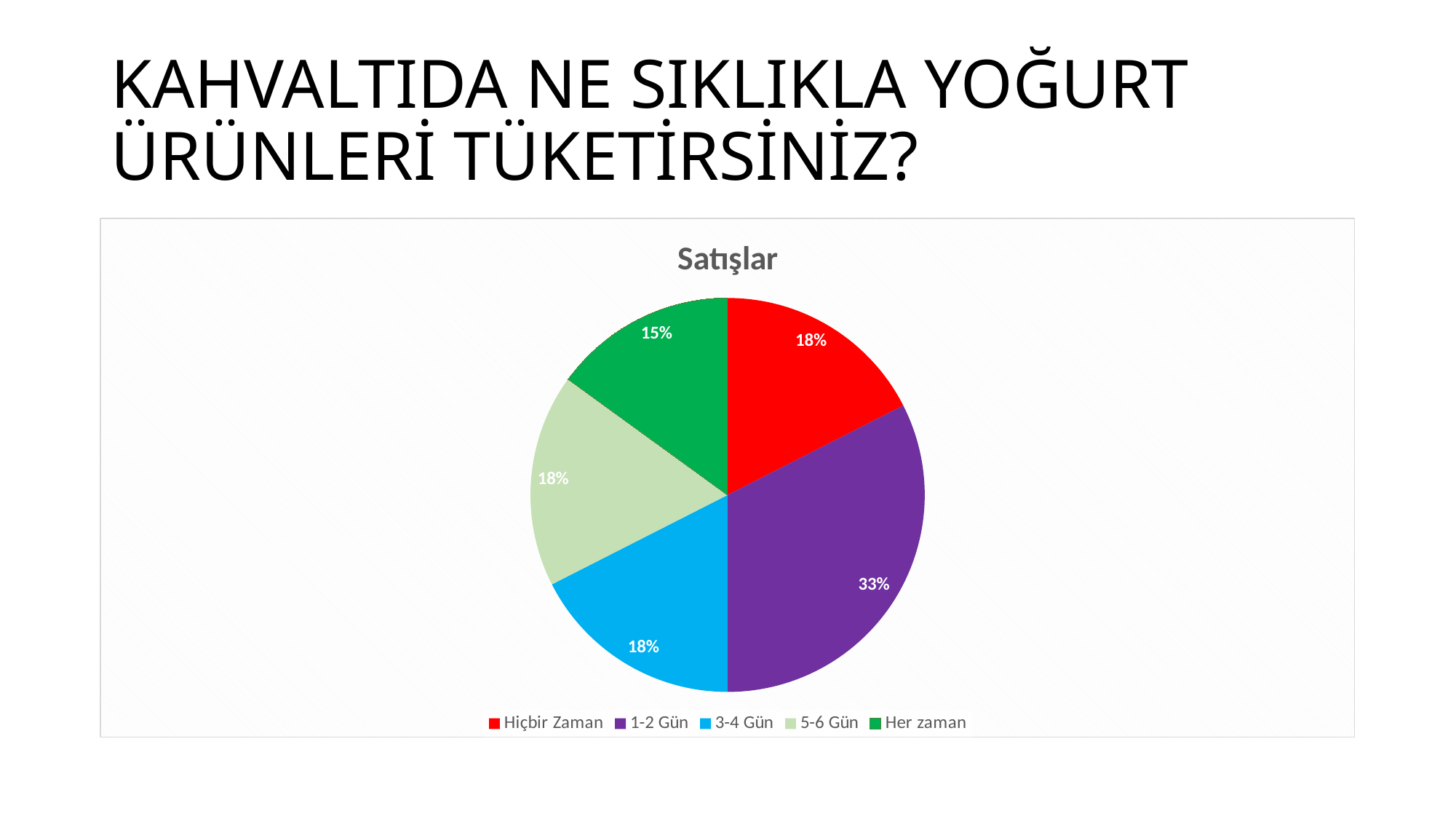
What is the difference in percentage points between the '1-2 Gün' slice and the 'Her zaman' slice? 18 How many categories does the pie chart have? 5 What share of the pie does the 'Hiçbir Zaman' slice represent? 18% What share of the pie does the '1-2 Gün' slice represent? 33% What share of the pie does the '3-4 Gün' slice represent? 18% Which category has the largest slice of the pie? 1-2 Gün Which is larger, the '1-2 Gün' slice or the '5-6 Gün' slice? 1-2 Gün What is the chart's title? Satışlar What kind of chart is shown on the slide? pie chart What colour is the '1-2 Gün' slice? purple Which category has the smallest slice of the pie? Her zaman